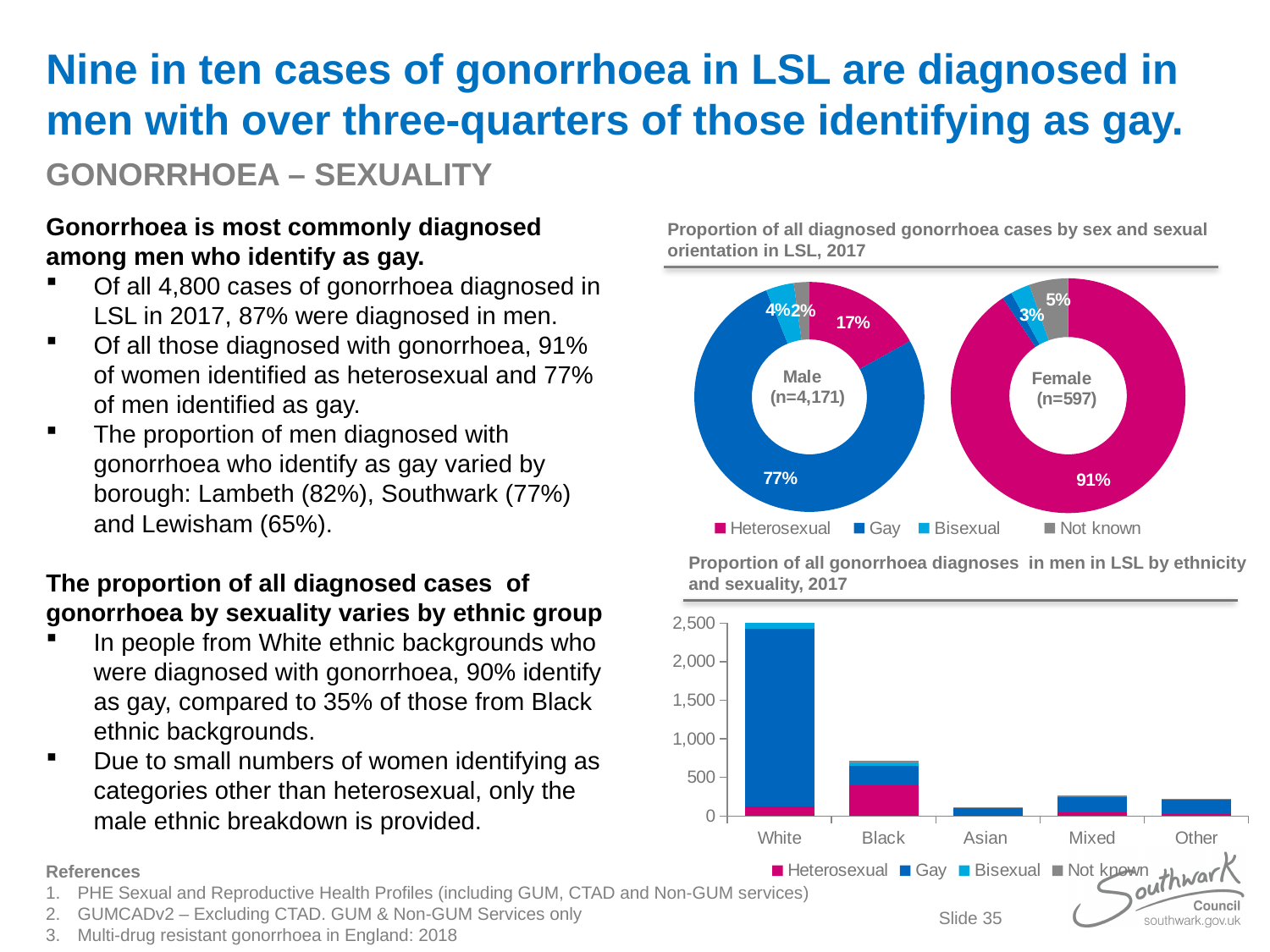
What kind of chart is the chart of gonorrhoea diagnoses in men by ethnicity and sexuality? Stacked bar chart How many categories does the legend of the donut chart of gonorrhoea cases by sex and sexual orientation list? 4 In the donut chart of gonorrhoea cases by sex and sexual orientation, how many percentage points higher is the gay share than the heterosexual share among men? 60 percentage points In the donut chart of gonorrhoea cases by sex and sexual orientation, what is the number of male cases (n) shown in the centre of the male donut? 4,171 In the donut chart of gonorrhoea cases by sex and sexual orientation, what proportion of male cases identified as bisexual? 4% In the donut chart of gonorrhoea cases by sex and sexual orientation, what proportion of female cases had sexual orientation not known? 5% In the donut chart of gonorrhoea cases by sex and sexual orientation, what proportion of female cases identified as heterosexual? 91% How many ethnic groups are shown on the x axis of the chart of gonorrhoea diagnoses in men by ethnicity and sexuality? 5 In the chart of gonorrhoea diagnoses in men by ethnicity and sexuality, which ethnic group has the tallest bar? White In the donut chart of gonorrhoea cases by sex and sexual orientation, what proportion of male cases identified as gay? 77% In the chart of gonorrhoea diagnoses in men by ethnicity and sexuality, is the total bar for Black greater or less than 1,000? less In the donut chart of gonorrhoea cases by sex and sexual orientation, what proportion of male cases identified as heterosexual? 17%